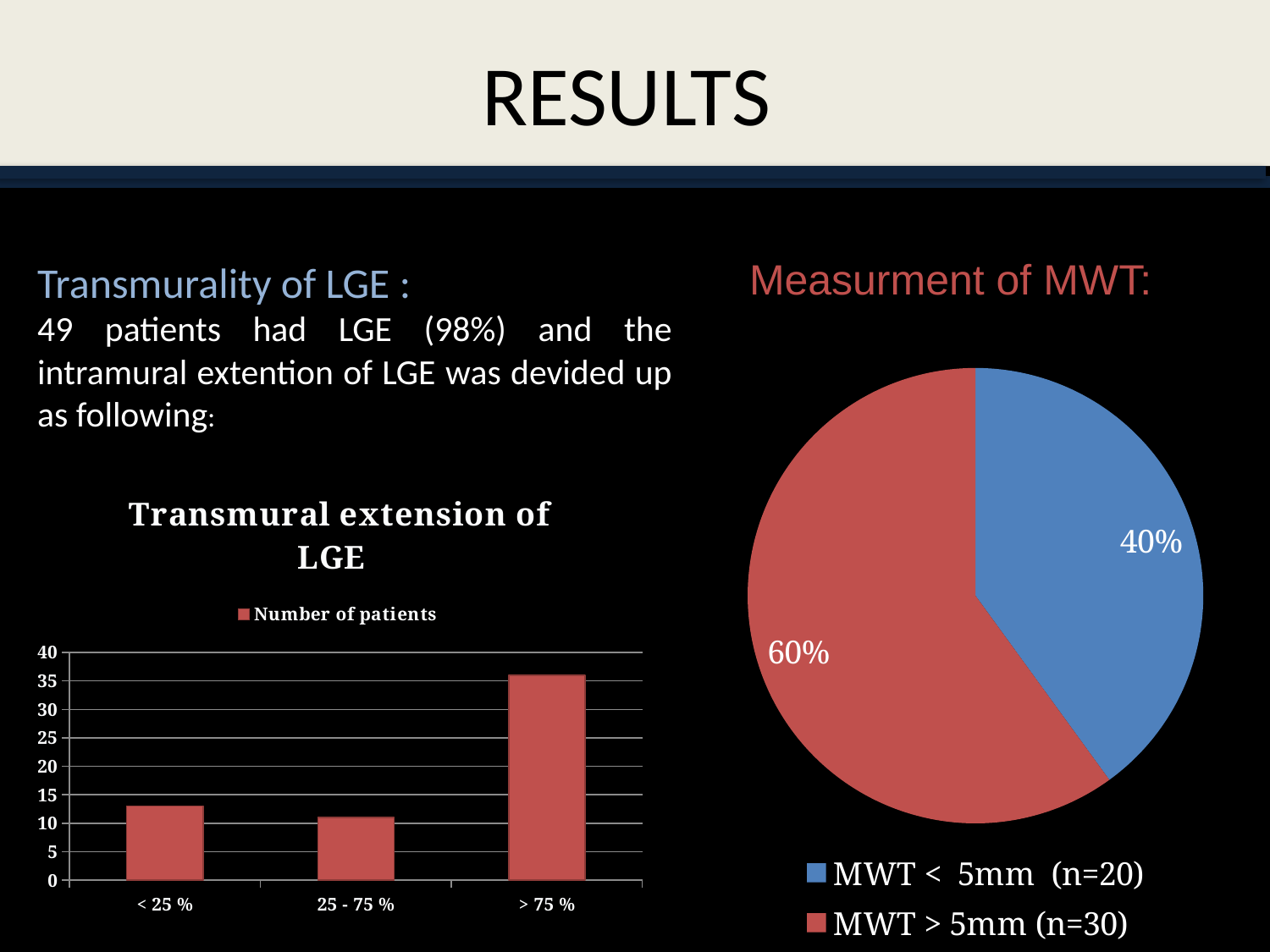
In the 'Transmural extension of LGE' chart, is the value for > 75 % greater or less than 30? greater In the 'Measurment of MWT' pie chart, what share is MWT < 5mm (n=20)? 40% In the 'Measurment of MWT' pie chart, which slice is larger, MWT < 5mm or MWT > 5mm? MWT > 5mm What series does the legend of the 'Transmural extension of LGE' chart list? Number of patients In the 'Measurment of MWT' pie chart, what is the difference between the MWT > 5mm share and the MWT < 5mm share? 20% In the 'Transmural extension of LGE' chart, is the value for 25 - 75 % greater or less than 15? less How many categories are shown in the 'Transmural extension of LGE' chart? 3 In the 'Transmural extension of LGE' chart, is the value for < 25 % greater or less than 10? greater What kind of chart is the 'Transmural extension of LGE' chart? bar chart What kind of chart is the 'Measurment of MWT' chart? pie chart In the 'Transmural extension of LGE' chart, which category has the highest number of patients? > 75 % In the 'Transmural extension of LGE' chart, which category has the lowest number of patients? 25 - 75 %